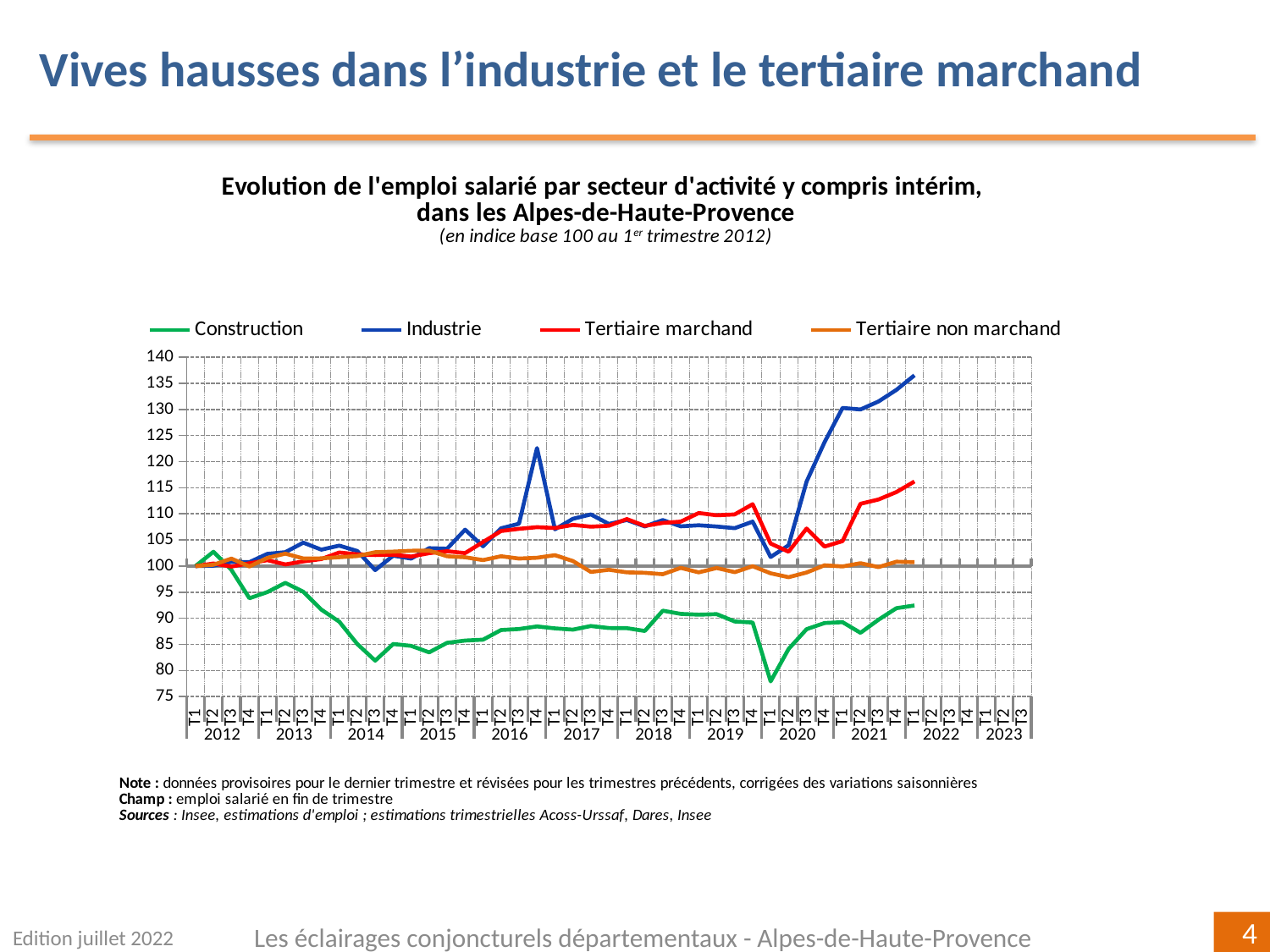
How many series does the legend list? 4 Which series has the lowest value at T1 2022? Construction At T1 2022, which is larger: Industrie or Tertiaire marchand? Industrie Which series is plotted in green? Construction Does the Industrie series rise or fall between T1 2020 and T1 2022? rise Which series has the highest value at T1 2022? Industrie What is the base period of the index used in the chart? 1er trimestre 2012 Is the value for Tertiaire marchand at T1 2022 greater or less than 110? greater Is the value for Industrie at T1 2022 greater or less than 130? greater Does the Construction series rise or fall between T2 2012 and T3 2014? fall Is the value for Construction at T1 2020 greater or less than 80? less What kind of chart is shown on the slide? line chart